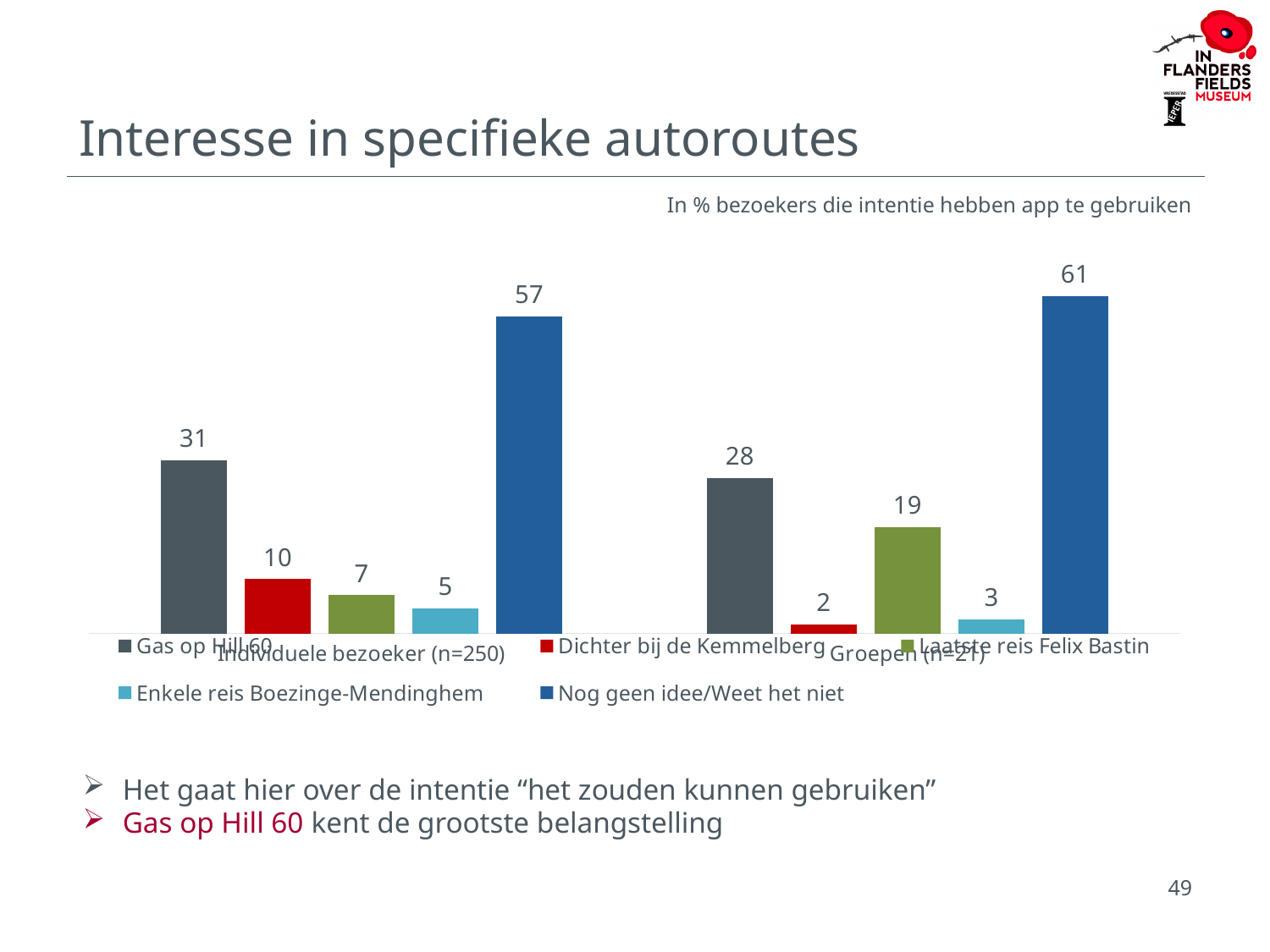
What is the difference between Gas op Hill 60 for Individuele bezoeker (n=250) and for Groepen (n=21)? 3 What is the title of the slide's chart? Interesse in specifieke autoroutes What kind of chart is shown on the slide? Bar chart Which is larger: Laatste reis Felix Bastin for Individuele bezoeker (n=250) or for Groepen (n=21)? Groepen (n=21) Which series has the highest value among Individuele bezoeker (n=250)? Nog geen idee/Weet het niet What is the value for Dichter bij de Kemmelberg among Individuele bezoeker (n=250)? 10 What is the value for Gas op Hill 60 among Individuele bezoeker (n=250)? 31 What is the value for Laatste reis Felix Bastin among Groepen (n=21)? 19 How many series does the legend list? 5 What is the value for Nog geen idee/Weet het niet among Groepen (n=21)? 61 How many categories are shown on the x axis? 2 Which series has the lowest value among Groepen (n=21)? Dichter bij de Kemmelberg